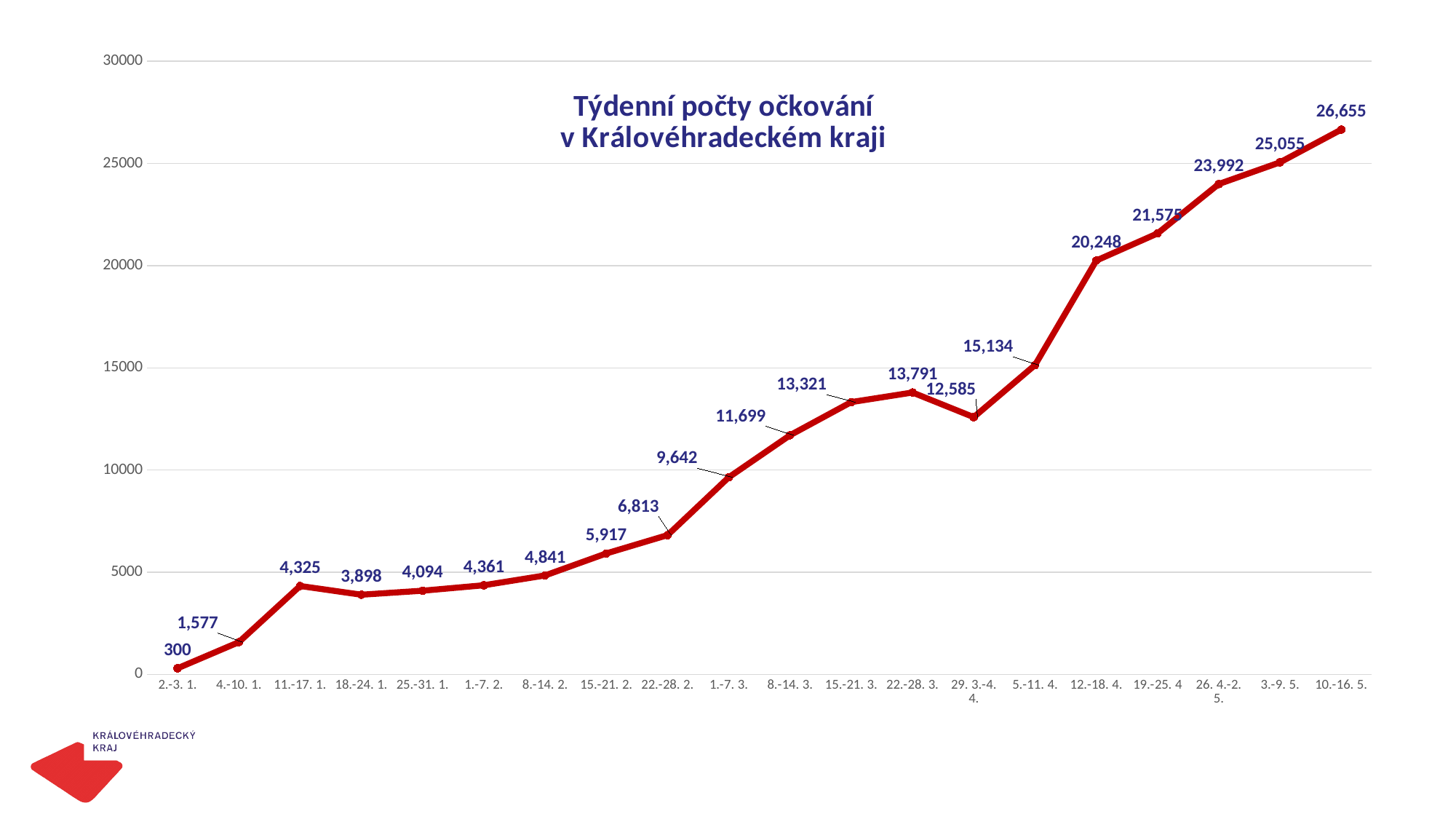
Which week has the highest value? 10.-16. 5. What is the value for the week 1.-7. 3.? 9,642 What is the value for the week 12.-18. 4.? 20,248 What is the title of the chart? Týdenní počty očkování v Královéhradeckém kraji What is the difference between the values for 10.-16. 5. and 3.-9. 5.? 1,600 What is the value for the week 2.-3. 1.? 300 How many weeks are plotted on the chart? 20 What is the difference between the values for 22.-28. 3. and 29. 3.-4. 4.? 1,206 Which is larger, the value for 11.-17. 1. or the value for 18.-24. 1.? 11.-17. 1. What kind of chart is shown on the slide? line chart Is the value for 5.-11. 4. greater or less than 15000? greater Which week has the lowest value? 2.-3. 1.